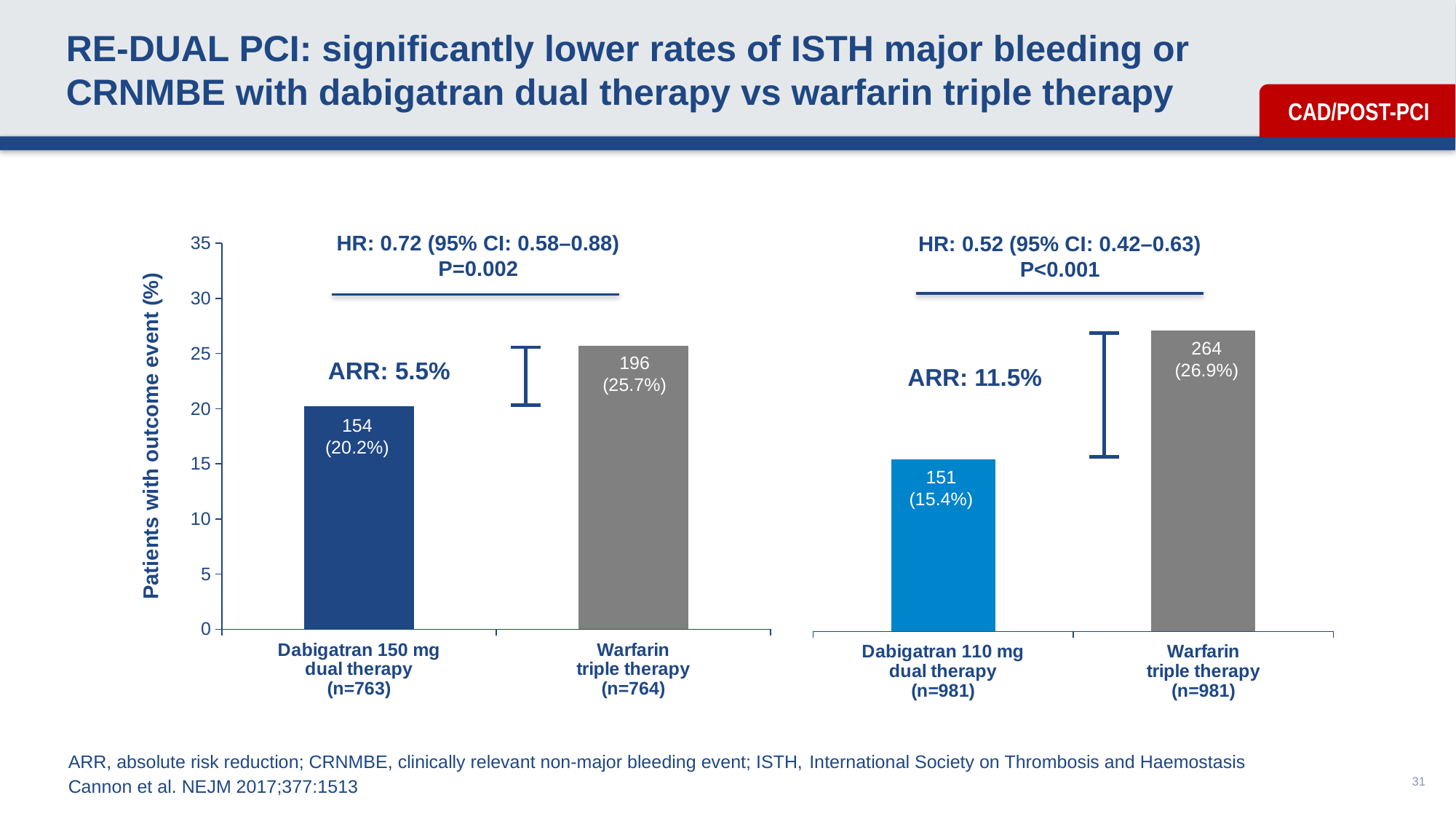
What is the y-axis label of the charts? Patients with outcome event (%) What type of chart is used on this slide? Bar chart How many bars are shown in the left chart? 2 In the left chart, what is the difference in percentage points between the warfarin triple therapy rate and the dabigatran 150 mg dual therapy rate? 5.5% In the right chart, how many patients had an outcome event with warfarin triple therapy? 264 In the right chart, which group has the higher rate of outcome events? Warfarin triple therapy In the left chart, how many patients had an outcome event with warfarin triple therapy? 196 In the left chart, which group has the lower rate of outcome events? Dabigatran 150 mg dual therapy In the left chart, what percentage of patients had an outcome event with dabigatran 150 mg dual therapy? 20.2% In the right chart, what percentage of patients had an outcome event with dabigatran 110 mg dual therapy? 15.4% In the right chart, what is the difference in percentage points between the warfarin triple therapy rate and the dabigatran 110 mg dual therapy rate? 11.5% In the right chart, is the value for dabigatran 110 mg dual therapy greater or less than 20? less